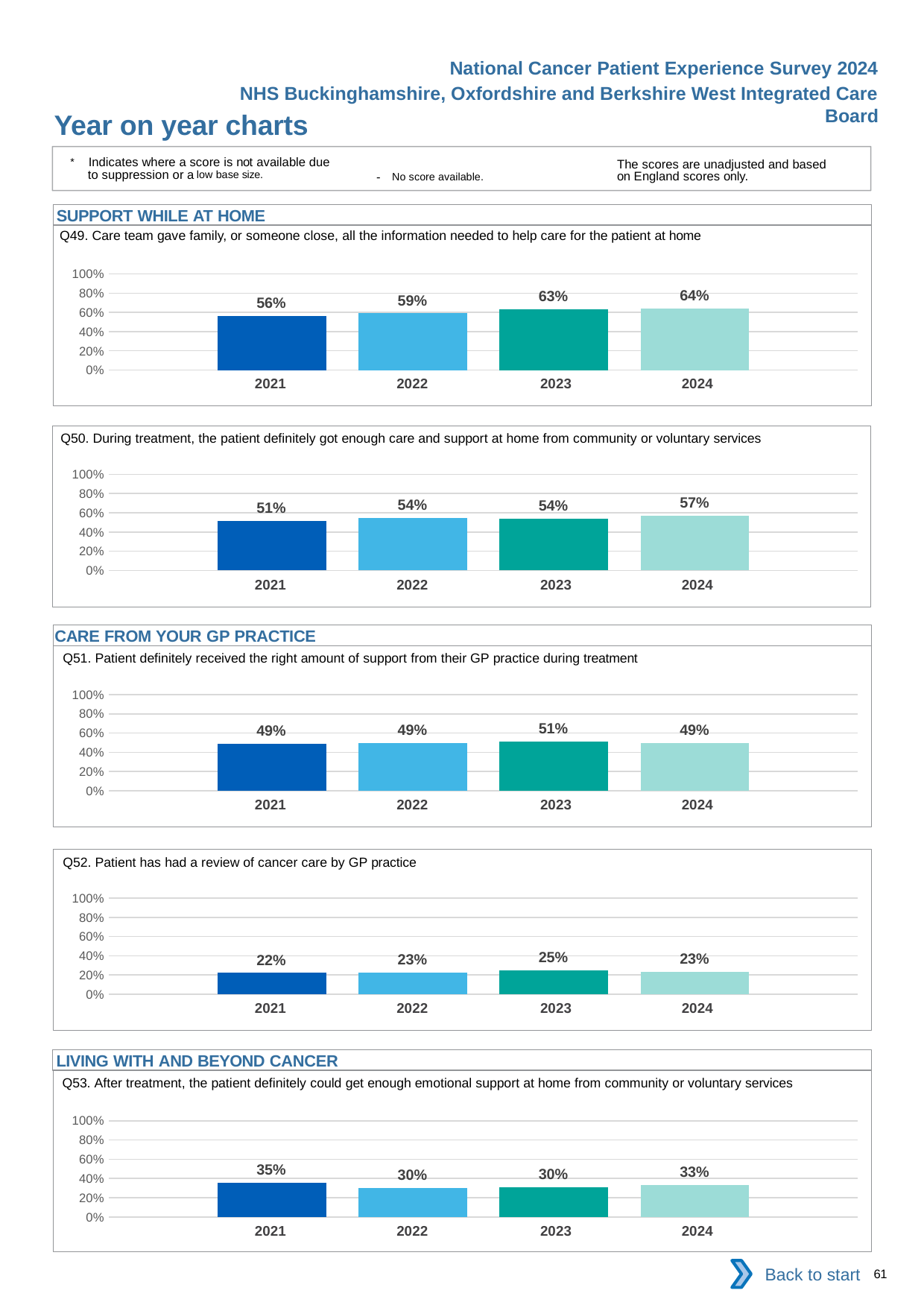
In the Q53 chart, which is larger, the value for 2021 or the value for 2024? 2021 In the Q53 chart, what is the value for 2022? 30% What kind of chart is the Q49 chart? bar chart In the Q51 chart, which year has the highest value? 2023 In the Q52 chart, how many years are plotted? 4 In the Q50 chart, what is the difference between the 2024 and 2021 values? 6 percentage points Which section heading appears above the Q53 chart? LIVING WITH AND BEYOND CANCER In the Q49 chart, what is the value for 2024? 64% In the Q51 chart, what is the value for 2022? 49% In the Q52 chart, is the value for 2023 greater or less than 40%? less In the Q49 chart, which year has the lowest value? 2021 In the Q50 chart, do the values generally rise or fall from 2021 to 2024? rise